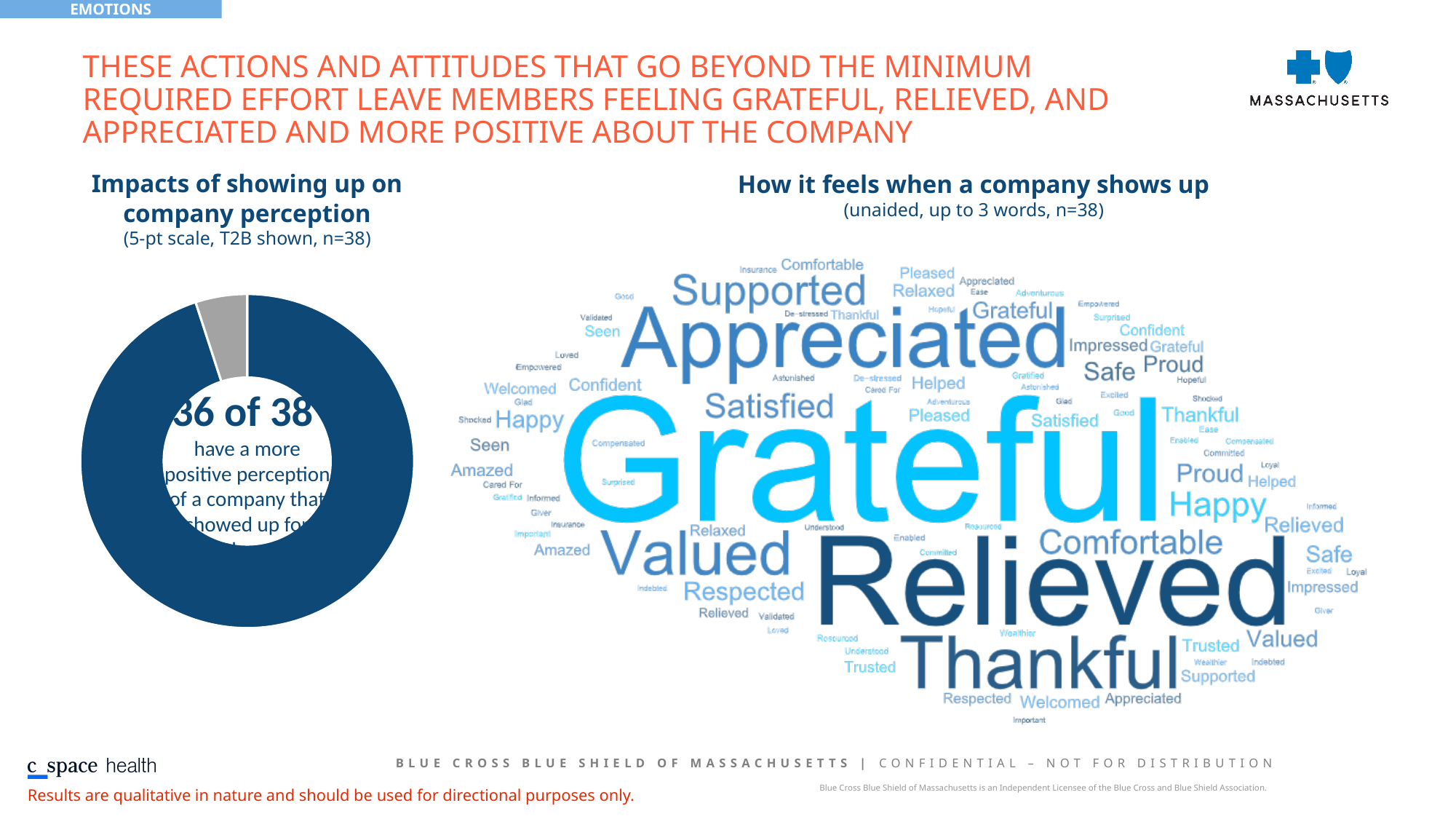
In the donut chart on the left, how many of the 38 respondents have a more positive perception of a company that showed up for them? 36 of 38 In the donut chart on the left, which slice is larger, the dark blue slice or the gray slice? Dark blue slice What scale is noted under the title of the donut chart on the left? 5-pt scale, T2B shown, n=38 In the donut chart on the left, what is the total number of respondents (n)? 38 In the word cloud on the right, which word is larger, 'Relieved' or 'Valued'? Relieved What kind of visualization is shown under the title 'How it feels when a company shows up'? Word cloud What kind of chart is shown under the title 'Impacts of showing up on company perception'? Donut chart In the word cloud on the right, which word appears largest? Grateful In the donut chart on the left, how many respondents are represented by the gray slice (those not in the 36)? 2 How many slices does the donut chart on the left have? 2 In the word cloud on the right, which word is larger, 'Appreciated' or 'Supported'? Appreciated What does the subtitle of the word cloud on the right say about how responses were collected? unaided, up to 3 words, n=38